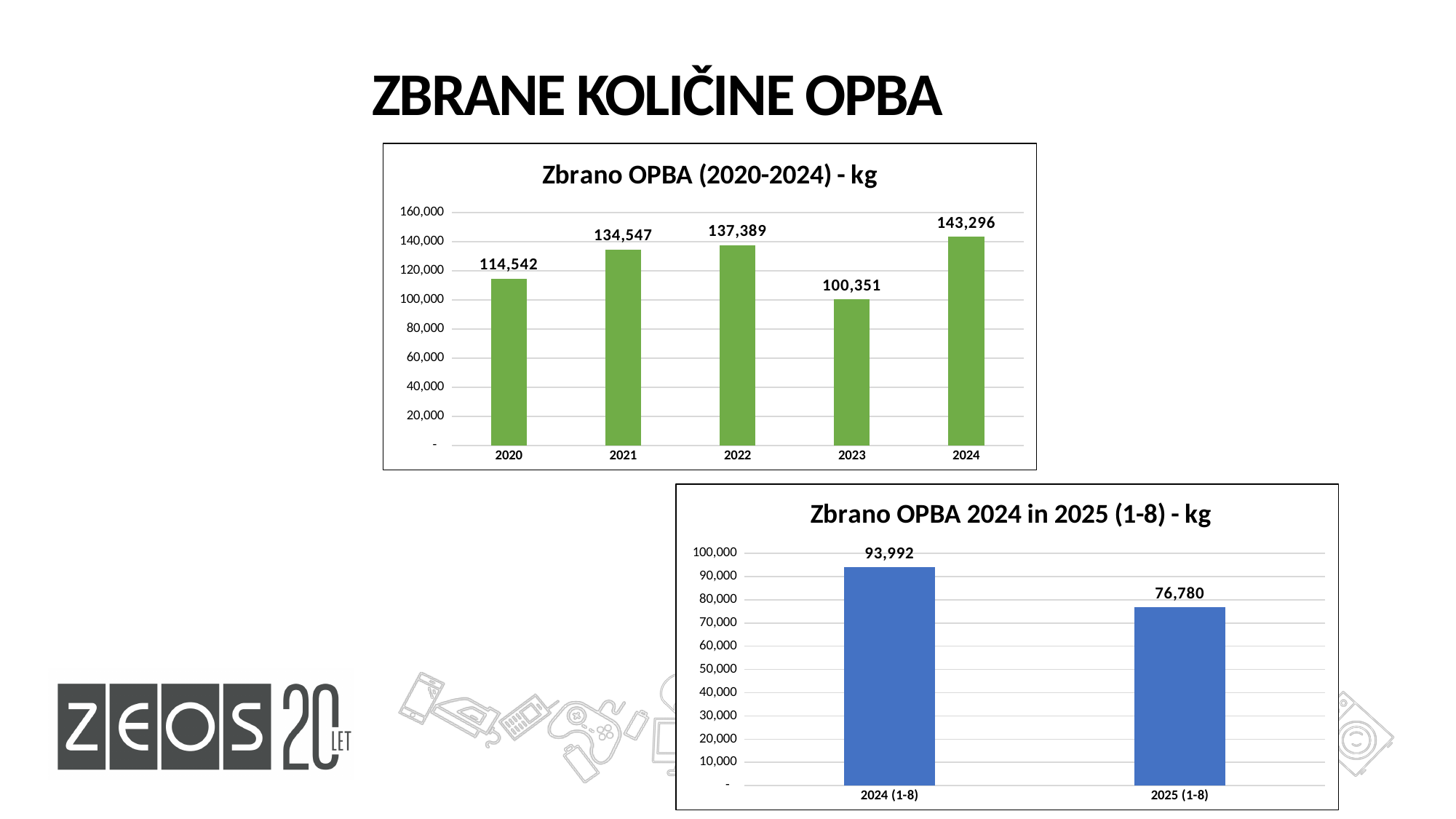
How many years are shown in the chart titled "Zbrano OPBA (2020-2024) - kg"? 5 In the chart titled "Zbrano OPBA 2024 in 2025 (1-8) - kg", what is the value for 2025 (1-8)? 76,780 In the chart titled "Zbrano OPBA 2024 in 2025 (1-8) - kg", do the values rise or fall from 2024 (1-8) to 2025 (1-8)? fall In the chart titled "Zbrano OPBA (2020-2024) - kg", which year has the highest value? 2024 In the chart titled "Zbrano OPBA (2020-2024) - kg", what is the value for 2022? 137,389 What colour are the bars in the chart titled "Zbrano OPBA 2024 in 2025 (1-8) - kg"? blue In the chart titled "Zbrano OPBA (2020-2024) - kg", which year has the lowest value? 2023 In the chart titled "Zbrano OPBA (2020-2024) - kg", is the value for 2023 greater or less than 120,000? less What kind of chart is the chart titled "Zbrano OPBA (2020-2024) - kg"? bar chart In the chart titled "Zbrano OPBA (2020-2024) - kg", what is the difference between the values for 2024 and 2023? 42,945 In the chart titled "Zbrano OPBA (2020-2024) - kg", which is larger, the value for 2021 or the value for 2020? 2021 In the chart titled "Zbrano OPBA 2024 in 2025 (1-8) - kg", what is the difference between the values for 2024 (1-8) and 2025 (1-8)? 17,212